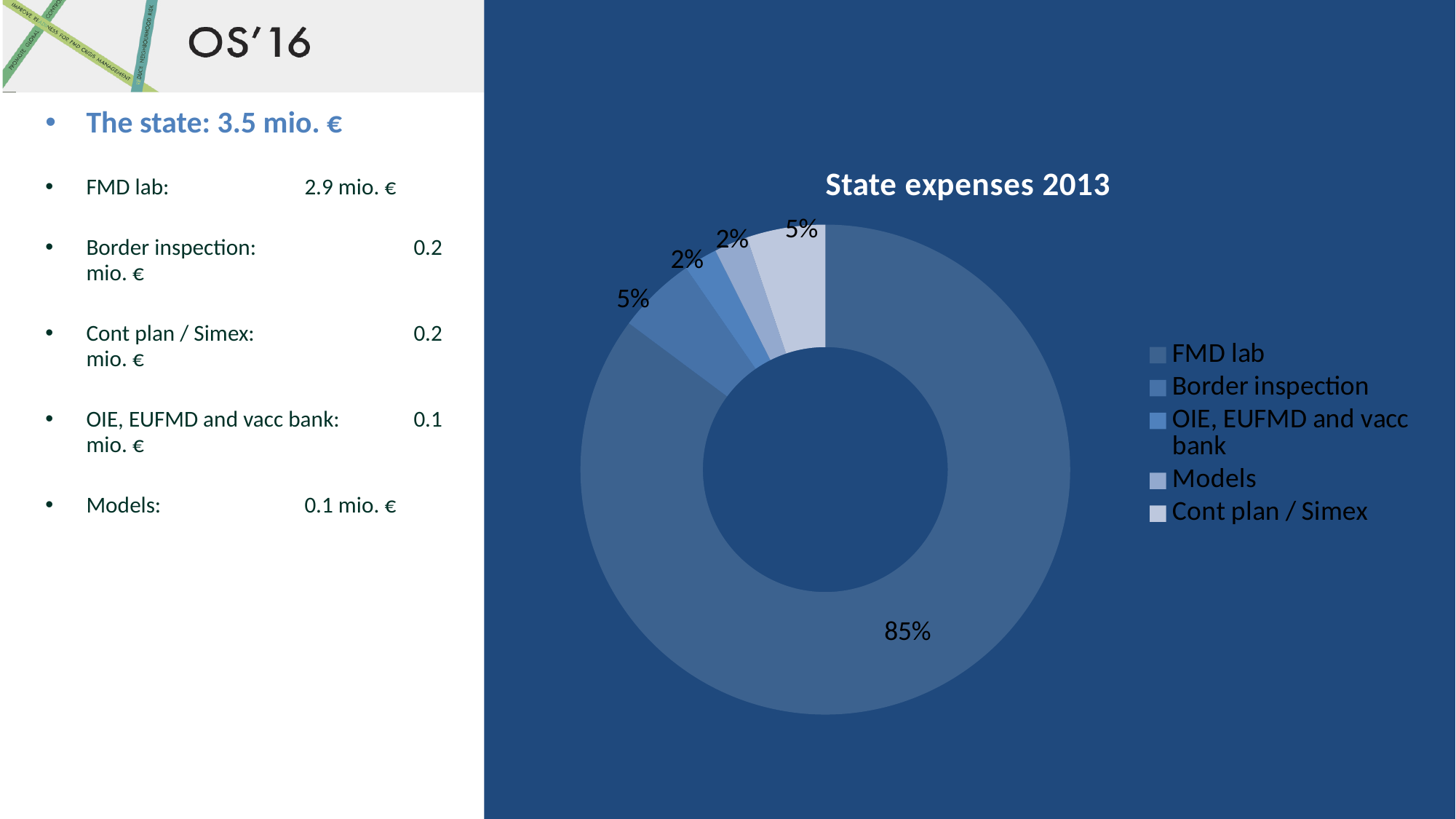
What share of state expenses 2013 does Models account for? 2% What is the title of the chart? State expenses 2013 What share of state expenses 2013 does FMD lab account for? 85% How many percentage points larger is the FMD lab share than the Border inspection share? 80 percentage points What share of state expenses 2013 does Border inspection account for? 5% What kind of chart is shown on the slide? Doughnut (pie) chart Which category has the largest share of state expenses 2013? FMD lab What share of state expenses 2013 does Cont plan / Simex account for? 5% Which has a larger share: Border inspection or Models? Border inspection How many categories does the chart show? 5 What share of state expenses 2013 does OIE, EUFMD and vacc bank account for? 2% Which category is listed first in the chart legend? FMD lab